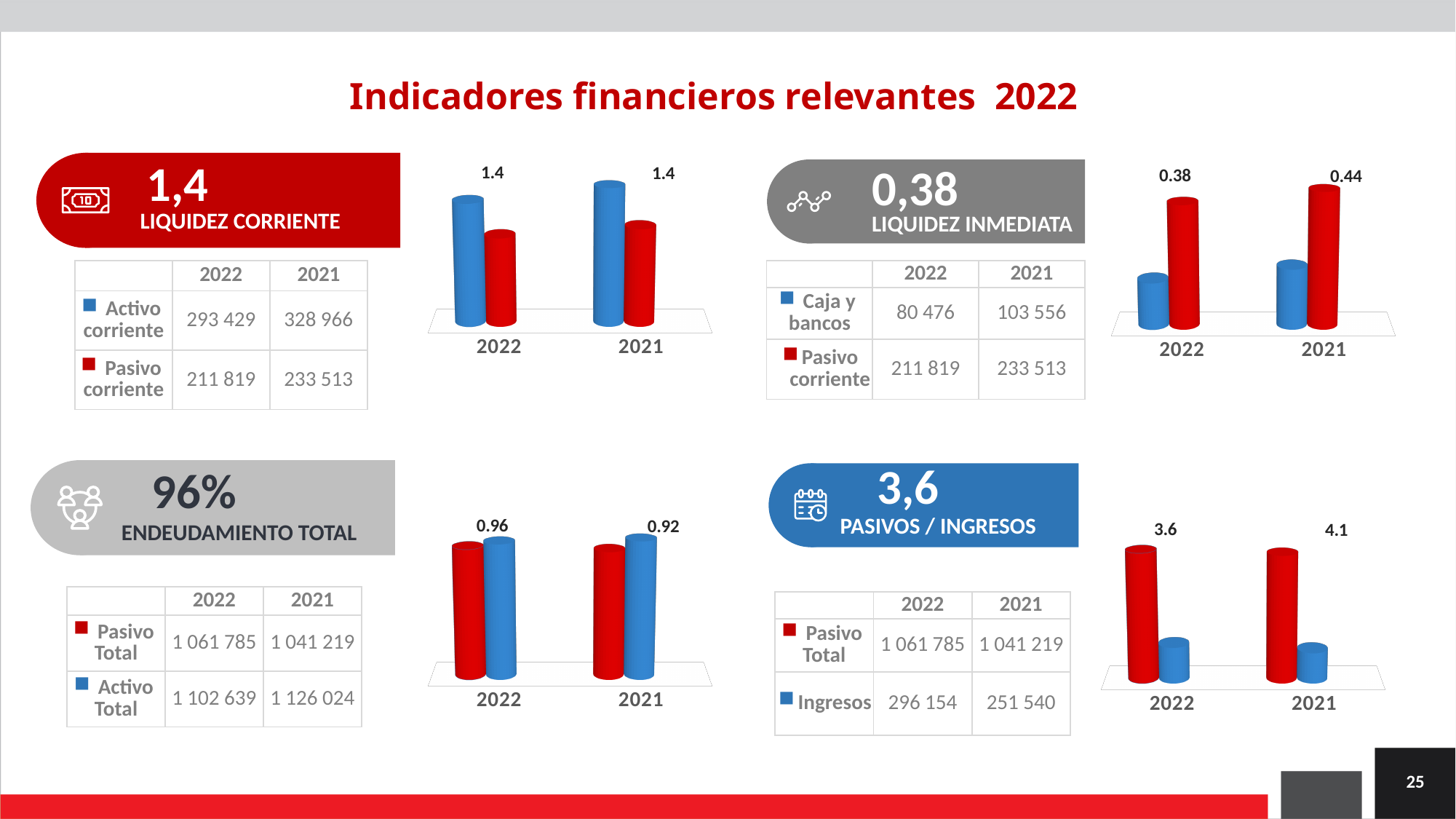
In the top-right chart (Liquidez inmediata), which year has the higher labelled value? 2021 In the bottom-right chart (Pasivos / Ingresos), what value is labelled above the bars for 2021? 4.1 In the bottom-right chart (Pasivos / Ingresos), which labelled value is larger, 2022 or 2021? 2021 In the top-right chart (Liquidez inmediata), what is the difference between the 2021 and 2022 labelled values? 0.06 What type of chart is the top-left chart (Liquidez corriente)? Bar chart In the bottom-left chart (Endeudamiento total), what value is labelled above the bars for 2022? 0.96 In the top-left chart (Liquidez corriente), what value is labelled above the bars for 2022? 1.4 In the bottom-left chart (Endeudamiento total), which year has the lower labelled value? 2021 In the top-right chart (Liquidez inmediata), what value is labelled above the bars for 2021? 0.44 In the bottom-right chart (Pasivos / Ingresos), what is the difference between the 2021 and 2022 labelled values? 0.5 In the top-right chart (Liquidez inmediata), for 2022, which bar is taller, the blue bar or the red bar? The red bar How many year categories are shown on the x axis of the bottom-right chart (Pasivos / Ingresos)? 2